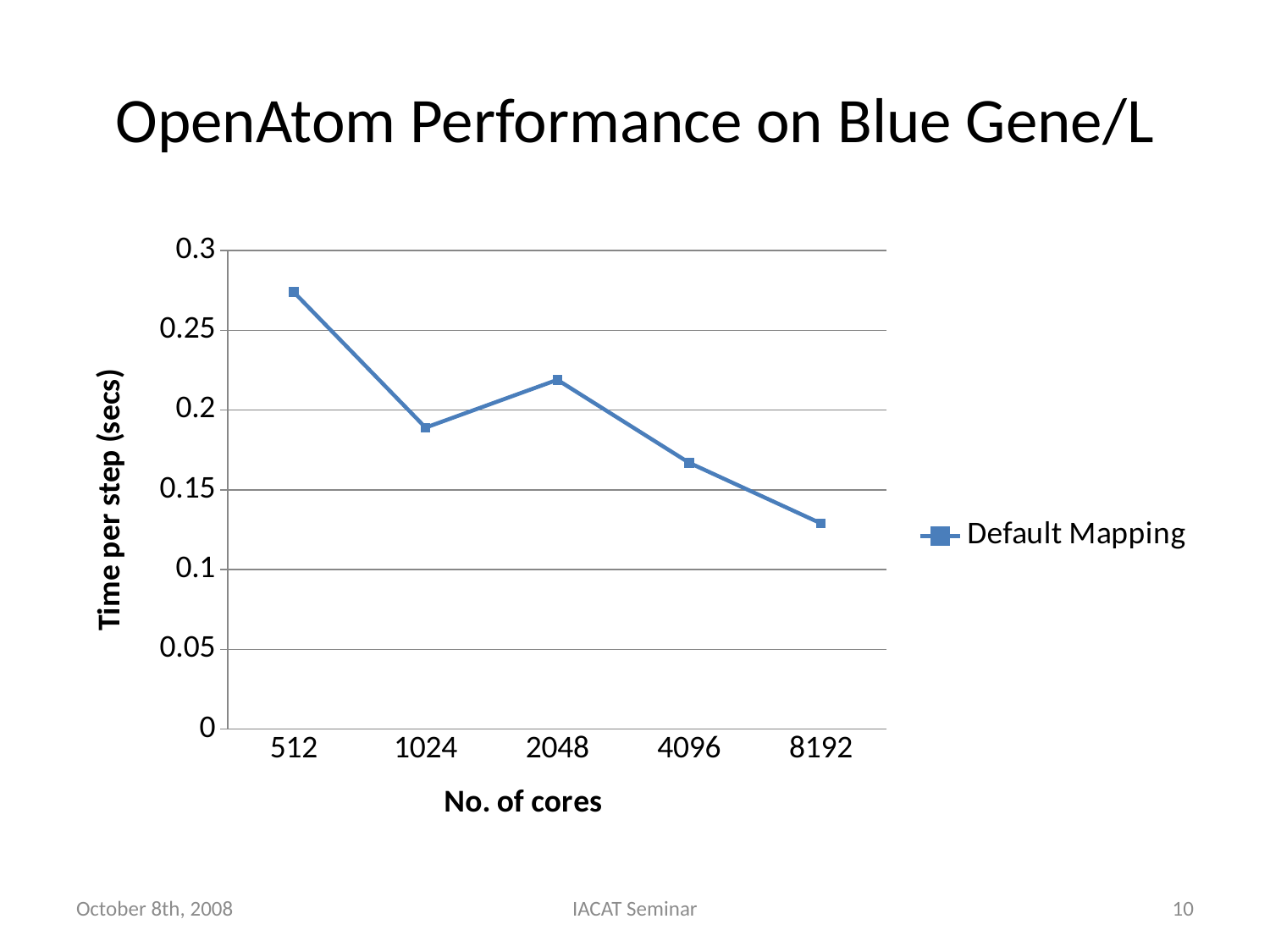
Is the time per step at 8192 cores greater or less than 0.15? less What is the label of the y axis? Time per step (secs) Is the time per step at 1024 cores greater or less than 0.2? less At which number of cores is the time per step lowest? 8192 Is the time per step at 512 cores greater or less than 0.25? greater How many series does the legend list? 1 What kind of chart is shown on the slide? Line chart At which number of cores is the time per step highest? 512 Does the time per step generally rise or fall as the number of cores increases from 512 to 8192? Fall How many data points are plotted on the Default Mapping line? 5 Which has a higher time per step, 1024 cores or 2048 cores? 2048 cores